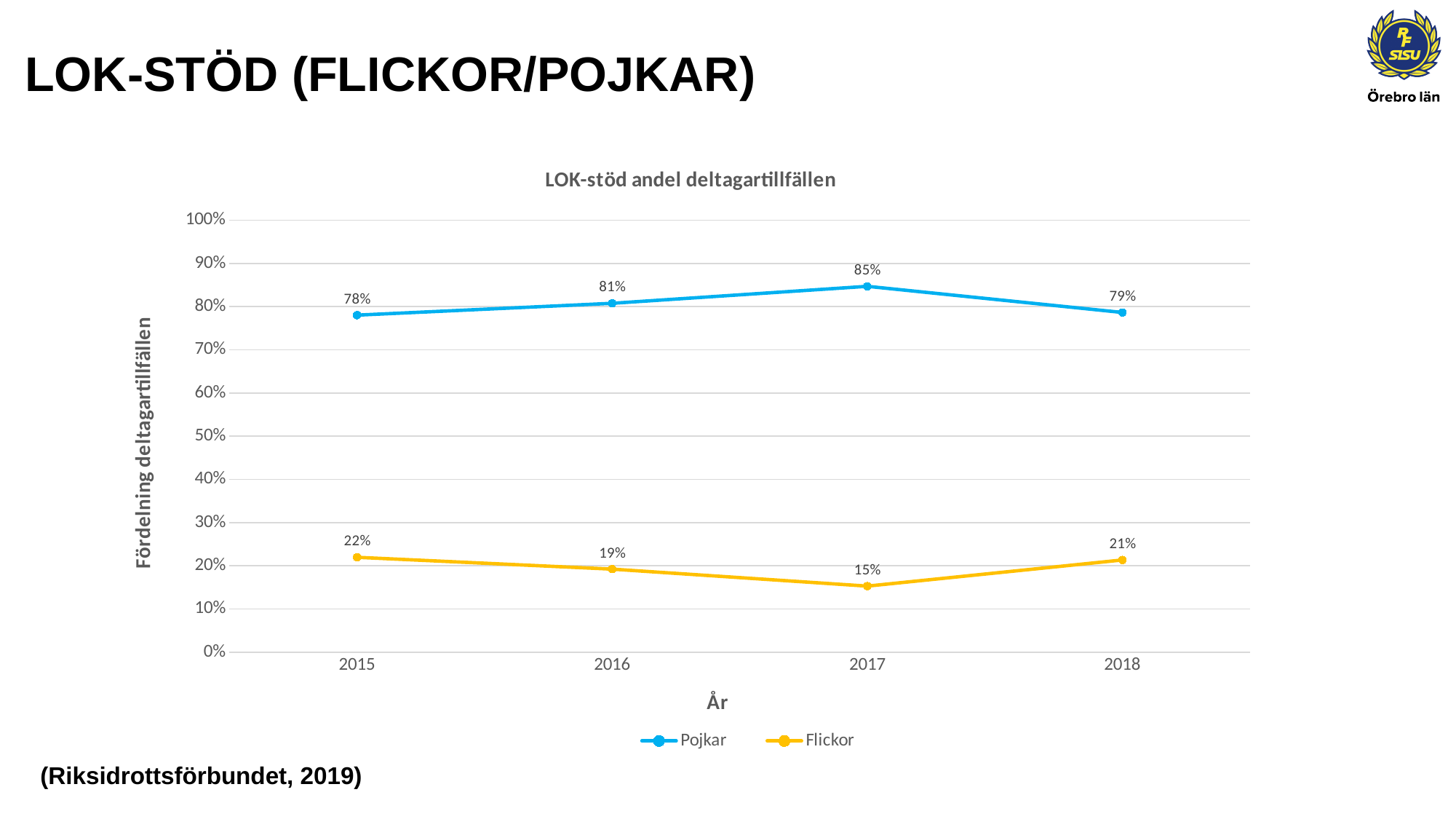
What is the difference between the Pojkar and Flickor values in 2016? 62% What is the value for Flickor in 2018? 21% In which year is the Flickor value lowest? 2017 What is the value for Flickor in 2015? 22% What is the title of the chart? LOK-stöd andel deltagartillfällen What kind of chart is shown? line chart Which is larger, the Flickor value in 2015 or in 2017? 2015 What is the value for Pojkar in 2017? 85% How many years are shown on the x axis? 4 Is the value for Pojkar in 2018 greater or less than 70%? greater How many series does the legend list? 2 In which year is the Pojkar value highest? 2017